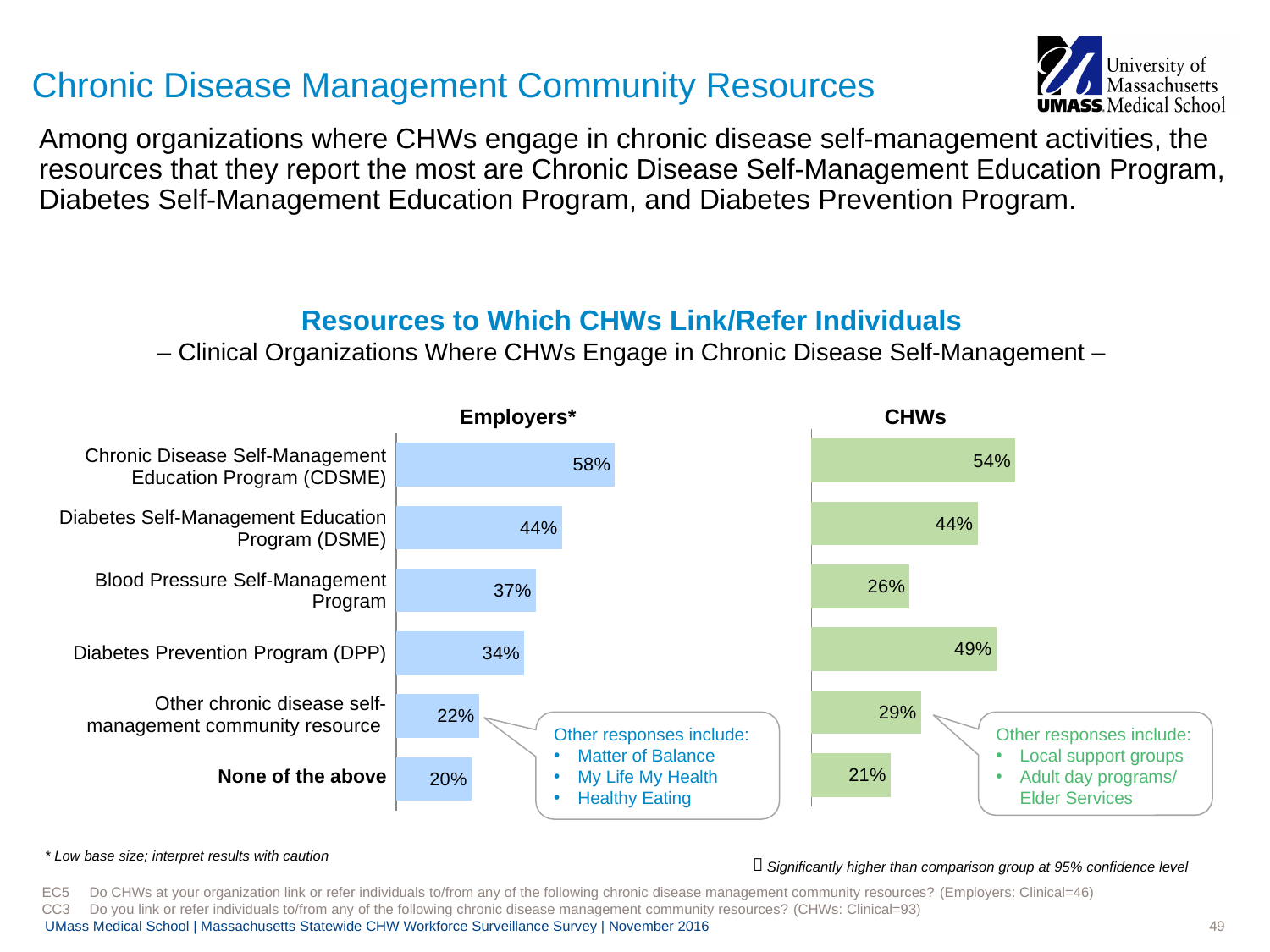
In the CHWs chart, which category has the lowest percentage? None of the above Which is larger: the Employers* value for Diabetes Prevention Program (DPP) or the CHWs value for Diabetes Prevention Program (DPP)? CHWs In the CHWs chart, what is the difference between the percentages for Diabetes Prevention Program (DPP) and Blood Pressure Self-Management Program? 23% In the Employers* chart, is the value for Blood Pressure Self-Management Program larger or smaller than the value for Diabetes Prevention Program (DPP)? larger What type of chart is used to show the CHWs data? bar chart What colour are the bars in the CHWs chart? green In the Employers* chart, which resource has the highest percentage? Chronic Disease Self-Management Education Program (CDSME) In the Employers* chart, what percentage is shown for Chronic Disease Self-Management Education Program (CDSME)? 58% In the CHWs chart, what percentage is shown for Blood Pressure Self-Management Program? 26% In the Employers* chart, what is the difference between the percentages for CDSME and DSME? 14% How many categories are plotted in the Employers* chart? 6 In the CHWs chart, what percentage is shown for Diabetes Prevention Program (DPP)? 49%